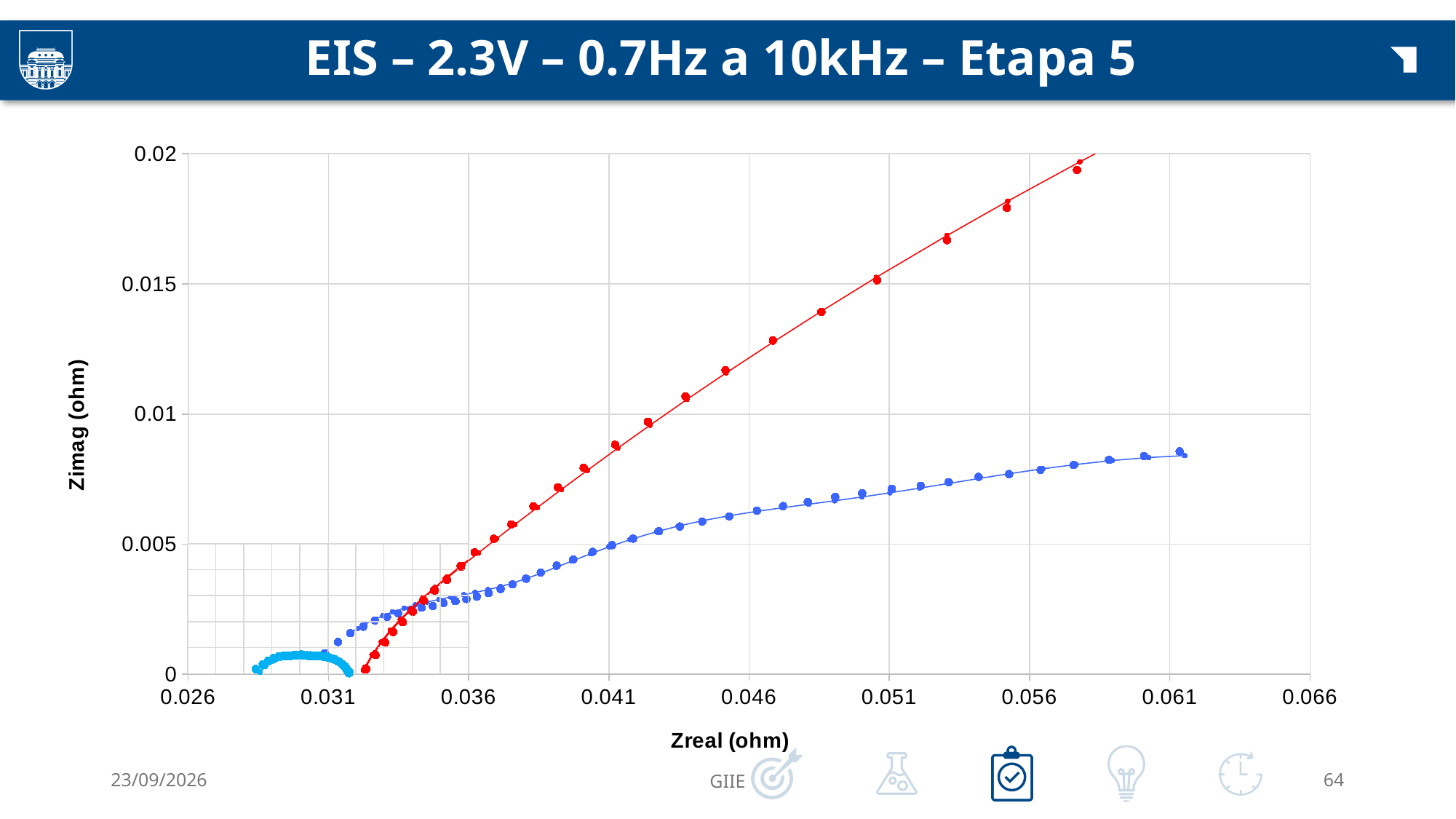
Is the highest Zimag value reached by the red series greater or less than 0.015? greater Is the Zimag value of the blue series at Zreal = 0.046 greater or less than 0.005? greater Is the Zimag value of the light blue series near Zreal = 0.031 greater or less than 0.005? less Does the Zimag value of the red series rise or fall as Zreal increases? Rise What is the label of the horizontal axis? Zreal (ohm) What is the largest value shown on the Zreal axis? 0.066 What is the title of the chart on the slide? EIS – 2.3V – 0.7Hz a 10kHz – Etapa 5 At Zreal = 0.051, which series has the larger Zimag value, the red or the blue? Red Which series reaches the highest Zimag value on the chart? The red series What kind of chart is shown on the slide? Scatter chart Which series extends to the largest Zreal value, the red or the blue? Blue